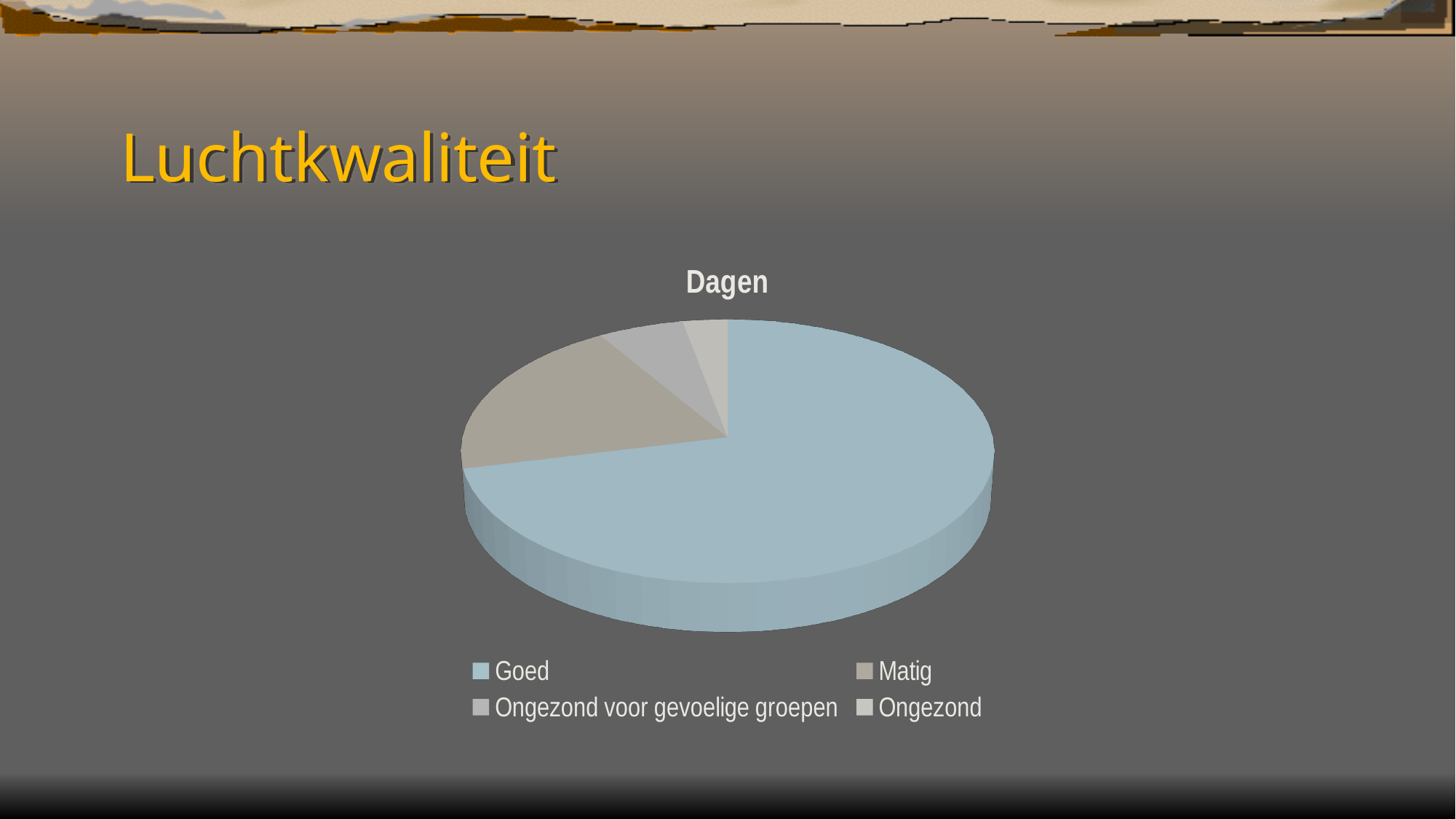
What kind of chart is shown on the slide? pie chart Which slice is larger, Goed or Matig? Goed Which category has the largest slice of the pie? Goed Which slice is larger, Matig or Ongezond? Matig Which category is shown in light blue in the legend? Goed How many categories does the pie chart have? 4 What is the title of the chart? Dagen Does the Goed slice take up more or less than half of the pie? more Which category has the smallest slice of the pie? Ongezond Which slice is larger, Matig or Ongezond voor gevoelige groepen? Matig